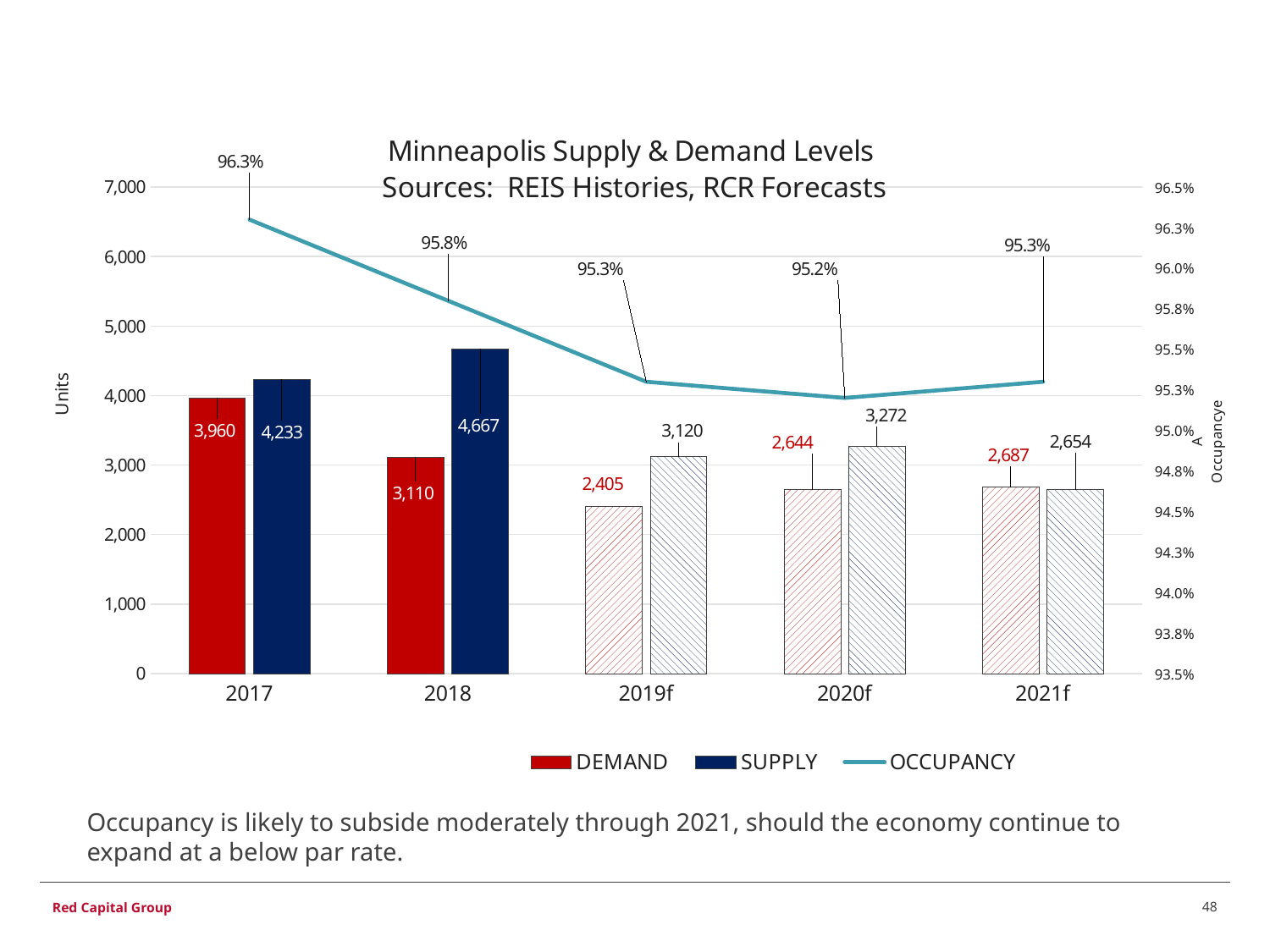
What is the SUPPLY value for 2020f? 3,272 Does the OCCUPANCY line rise or fall from 2017 to 2019f? Fall What kind of chart is this? Combined bar and line chart How many series does the legend list? 3 What is the OCCUPANCY value for 2017? 96.3% What is the title of the chart? Minneapolis Supply & Demand Levels What is the difference between SUPPLY and DEMAND in 2018? 1,557 Which is larger in 2021f, DEMAND or SUPPLY? DEMAND How many years are shown on the x axis? 5 Which year has the lowest DEMAND value? 2019f What is the DEMAND value for 2018? 3,110 Which year has the highest SUPPLY value? 2018